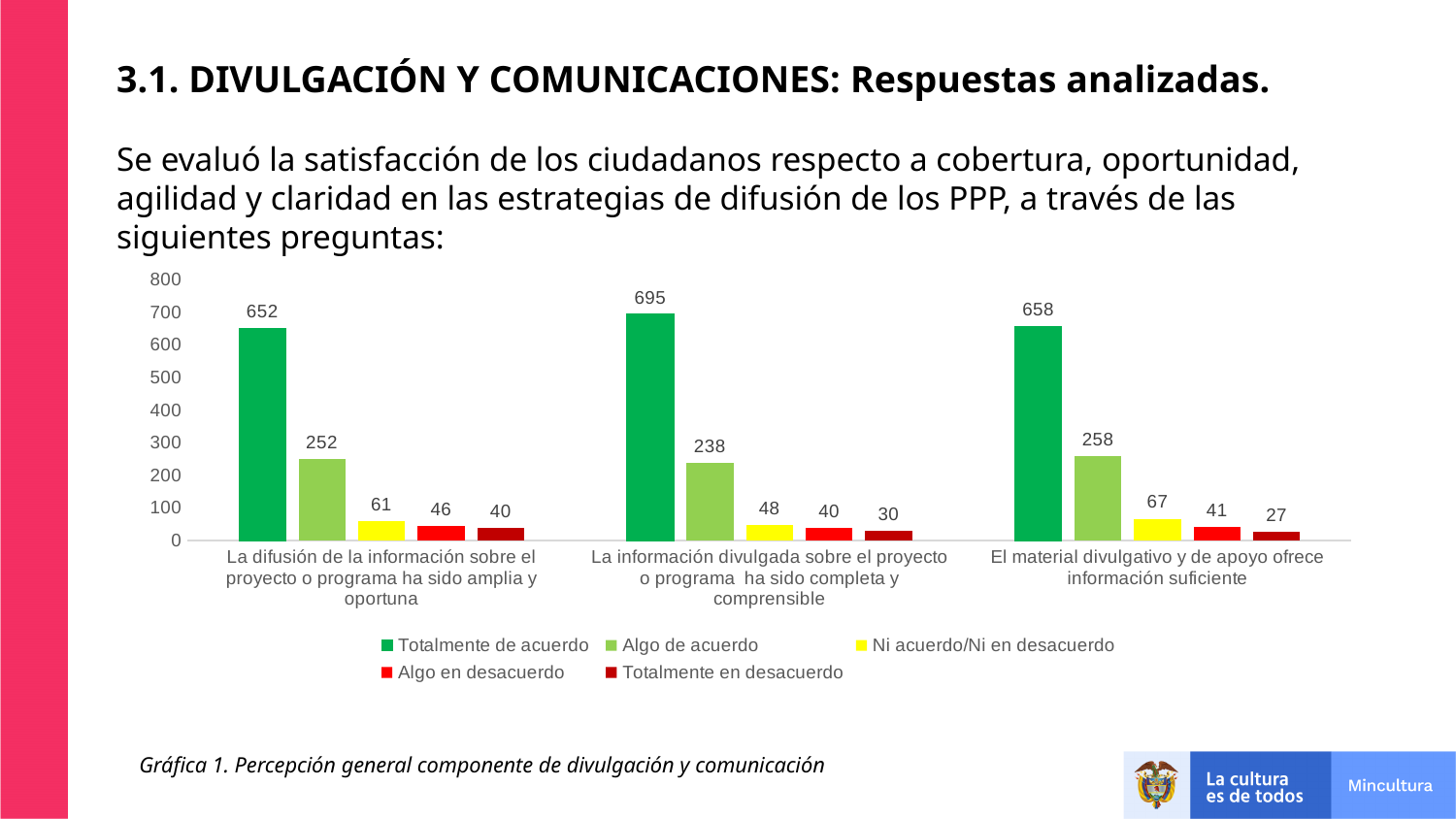
Is the value for "Totalmente de acuerdo" in "El material divulgativo y de apoyo ofrece información suficiente" greater or less than 600? greater What is the value for "Ni acuerdo/Ni en desacuerdo" in the category "La difusión de la información sobre el proyecto o programa ha sido amplia y oportuna"? 61 How many series does the legend list? 5 What is the value for "Totalmente de acuerdo" in the category "La información divulgada sobre el proyecto o programa ha sido completa y comprensible"? 695 Which is larger: "Algo en desacuerdo" in "La difusión de la información sobre el proyecto o programa ha sido amplia y oportuna" or "Algo en desacuerdo" in "La información divulgada sobre el proyecto o programa ha sido completa y comprensible"? La difusión de la información sobre el proyecto o programa ha sido amplia y oportuna Which category has the lowest value for "Totalmente en desacuerdo"? El material divulgativo y de apoyo ofrece información suficiente How many categories are shown on the x axis? 3 What colour represents the "Ni acuerdo/Ni en desacuerdo" series? Yellow What is the value for "Algo de acuerdo" in the category "El material divulgativo y de apoyo ofrece información suficiente"? 258 What kind of chart is shown on the slide? Bar chart What is the difference between "Totalmente de acuerdo" and "Algo de acuerdo" in the category "La difusión de la información sobre el proyecto o programa ha sido amplia y oportuna"? 400 Which category has the highest value for "Totalmente de acuerdo"? La información divulgada sobre el proyecto o programa ha sido completa y comprensible